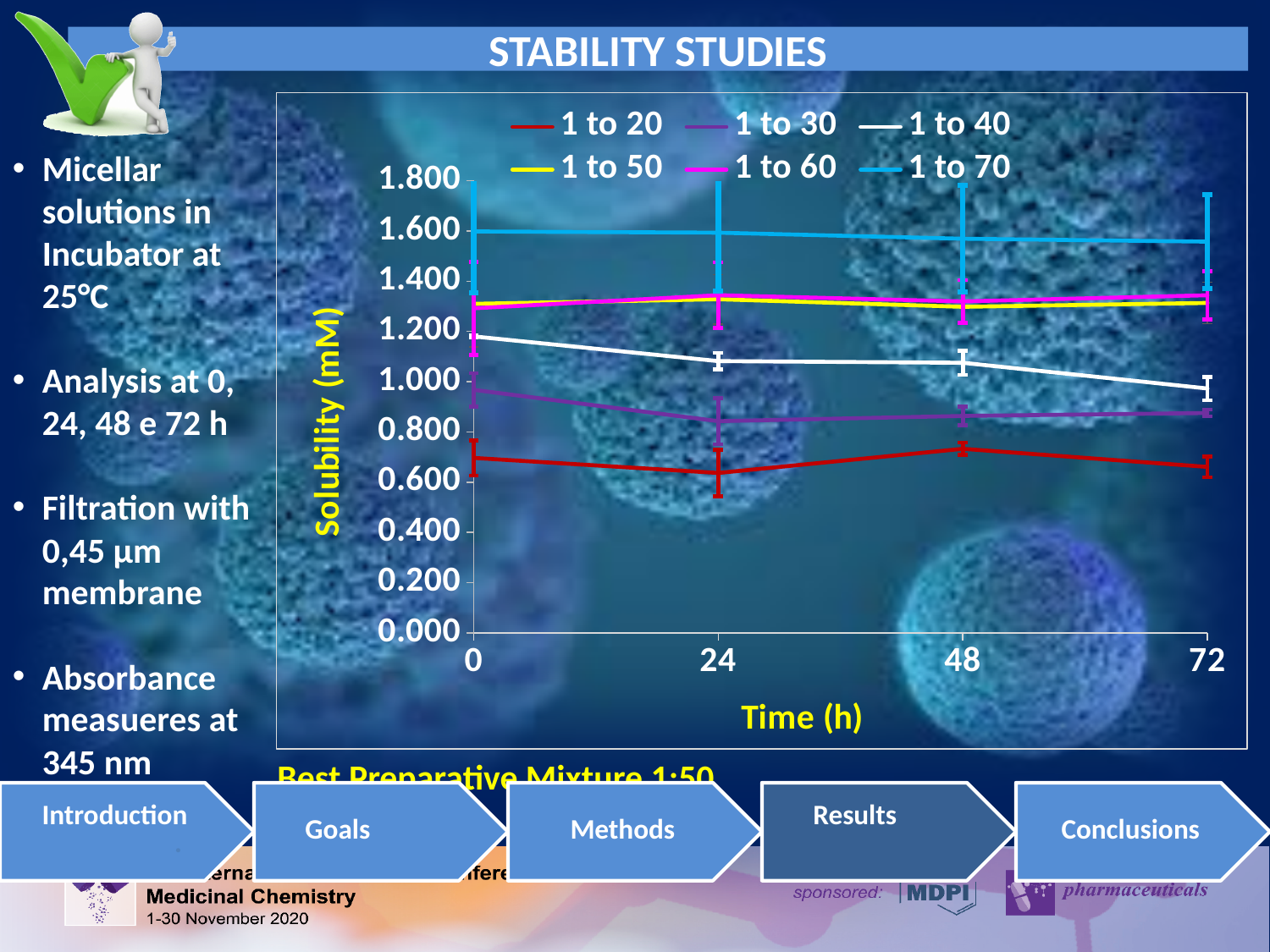
At 0 h, which series has the higher solubility, 1 to 40 or 1 to 30? 1 to 40 Does the solubility for the 1 to 40 series rise or fall from 0 h to 72 h? fall Is the solubility for the 1 to 70 series at 0 h greater or less than 1.400? greater What is the title of the y axis of the chart? Solubility (mM) What kind of chart is shown on the slide? line chart Is the solubility for the 1 to 30 series at 72 h greater or less than 1.000? less Is the solubility for the 1 to 20 series at 24 h greater or less than 0.800? less Which series has the highest solubility across all time points? 1 to 70 How many series does the chart legend list? 6 Which series has the lowest solubility across all time points? 1 to 20 How many time points are plotted along the x axis? 4